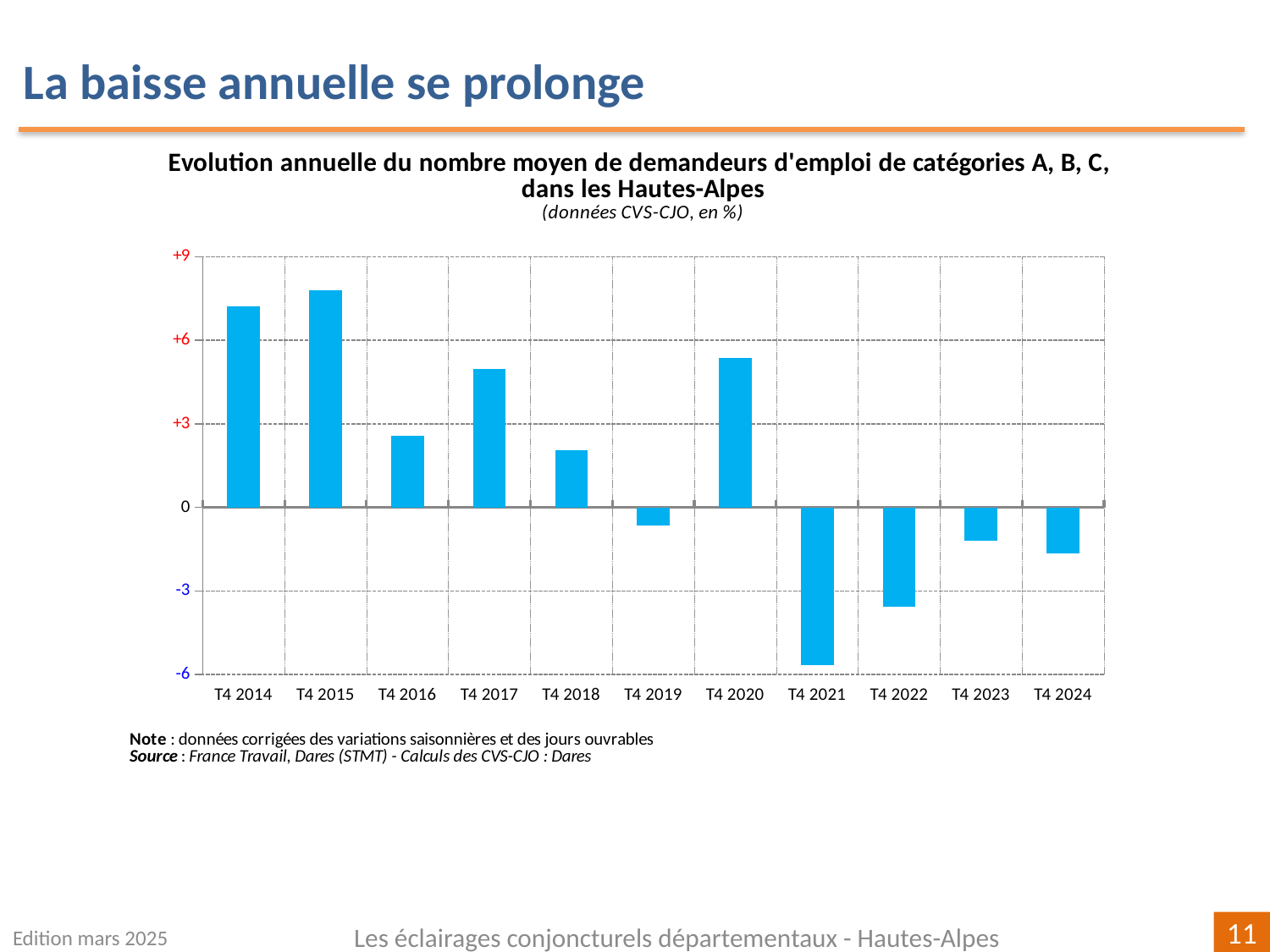
Which is larger, the value for T4 2020 or the value for T4 2019? T4 2020 Do the values rise or fall from T4 2020 to T4 2021? fall How many quarters (categories) are plotted on the x axis? 11 In what unit are the data expressed, according to the chart subtitle? en % Is the value for T4 2021 greater or less than -3? less Is the value for T4 2022 greater or less than -3? less What kind of chart is shown on the slide? bar chart Which quarter has the highest value? T4 2015 Is the value for T4 2014 greater or less than +6? greater Which is larger, the value for T4 2017 or the value for T4 2018? T4 2017 Which quarter has the lowest value? T4 2021